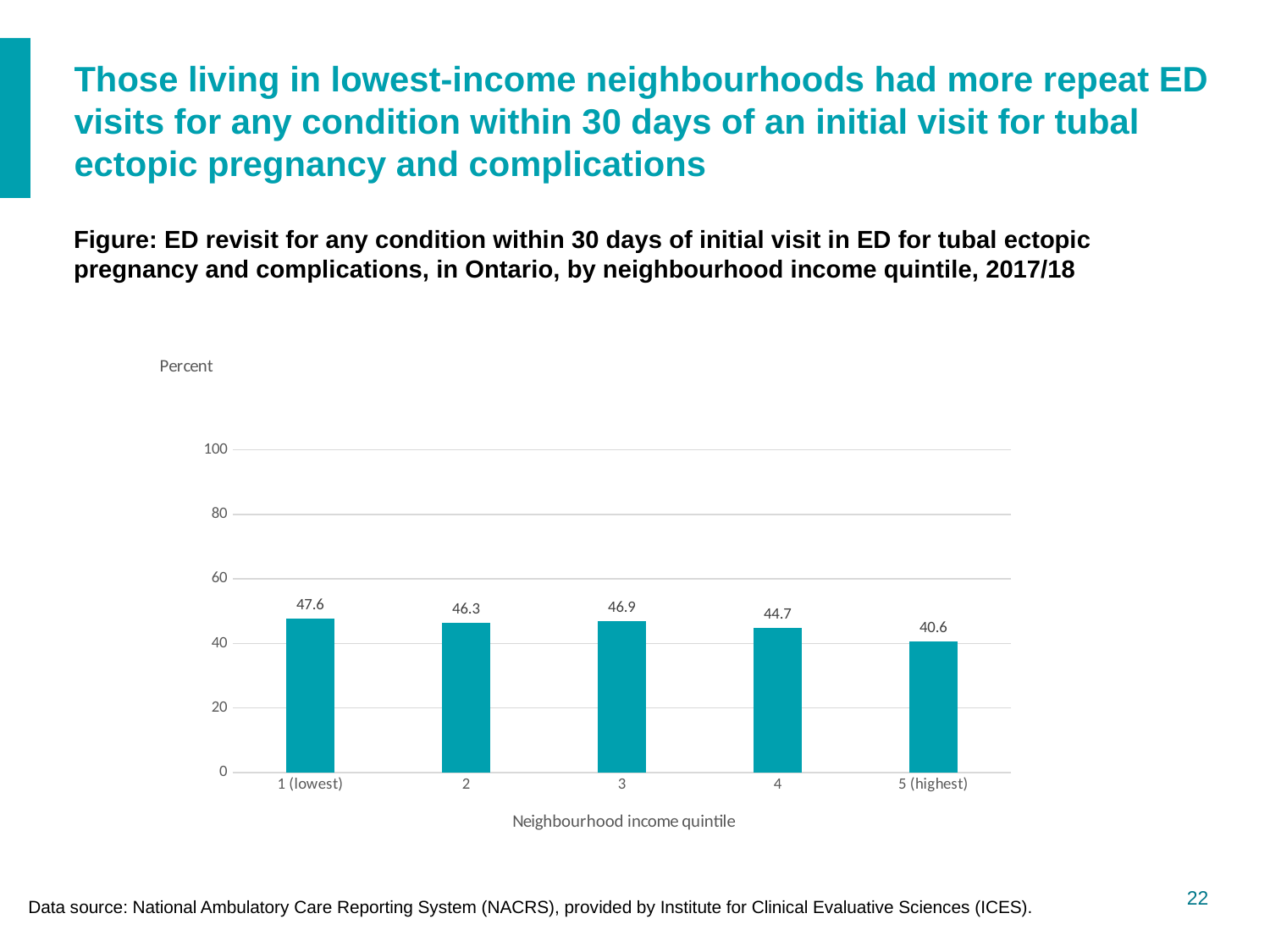
Which income quintile has the lowest percentage of ED revisits? 5 (highest) How many income quintile categories are shown on the chart? 5 What is the value for neighbourhood income quintile 5 (highest)? 40.6 What is the difference between the values for quintile 3 and quintile 4? 2.2 Which has a larger value, quintile 2 or quintile 4? 2 What is the difference between the values for quintile 1 (lowest) and quintile 5 (highest)? 7.0 What is the value for neighbourhood income quintile 1 (lowest)? 47.6 Is the value for quintile 4 greater or less than 40? greater What is the value for neighbourhood income quintile 3? 46.9 What is the label of the x axis? Neighbourhood income quintile What kind of chart is shown on the slide? Bar chart Which income quintile has the highest percentage of ED revisits? 1 (lowest)